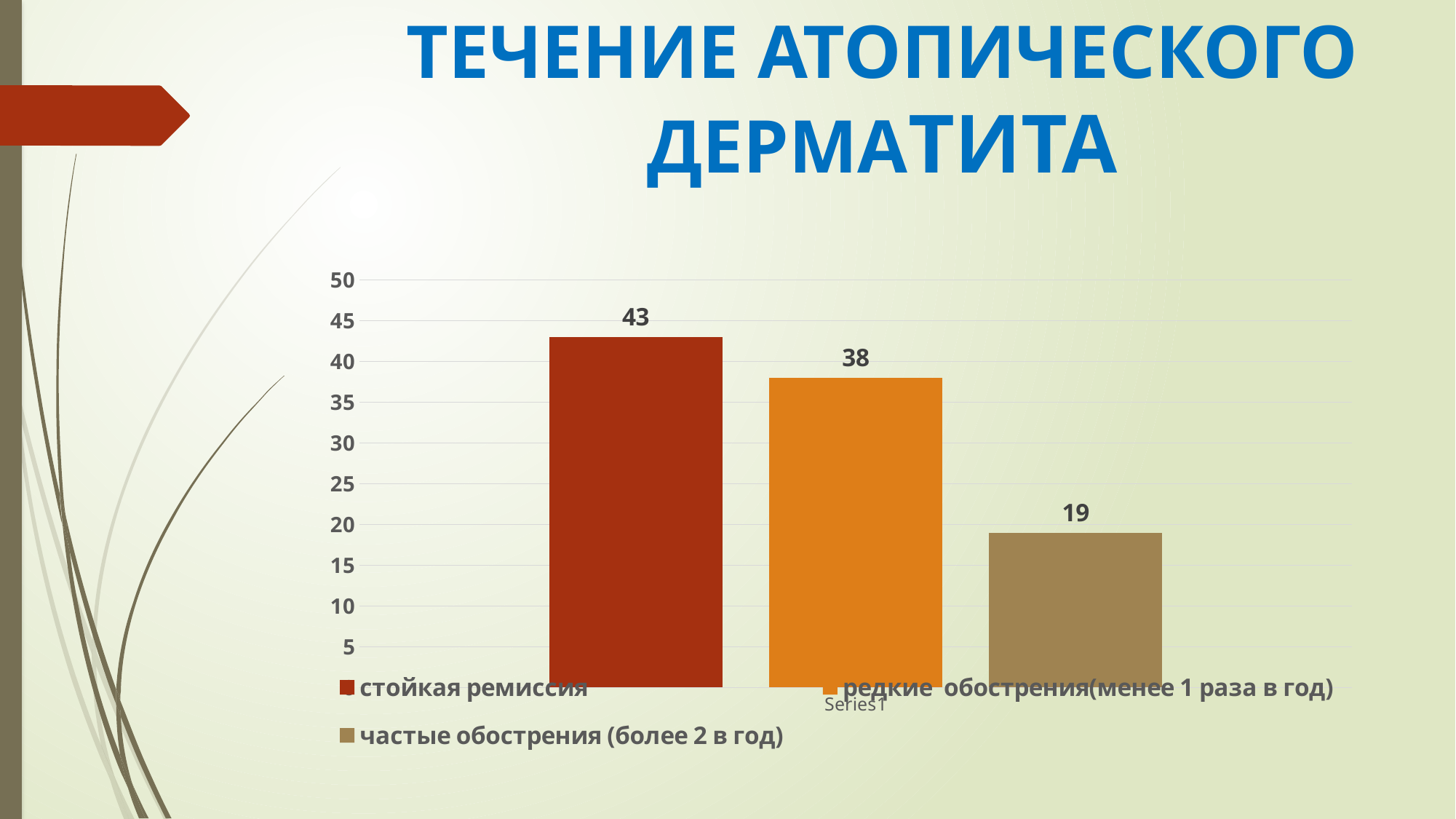
What is the difference between the values for стойкая ремиссия and редкие обострения (менее 1 раза в год)? 5 Which category has the highest value? стойкая ремиссия What kind of chart is shown on the slide? bar chart How many bars are plotted in the chart? 3 Which is larger, the value for редкие обострения (менее 1 раза в год) or the value for частые обострения (более 2 в год)? редкие обострения (менее 1 раза в год) What is the value for частые обострения (более 2 в год)? 19 What is the value for редкие обострения (менее 1 раза в год)? 38 What is the difference between the values for стойкая ремиссия and частые обострения (более 2 в год)? 24 Is the value for редкие обострения (менее 1 раза в год) greater or less than 40? less Which category has the lowest value? частые обострения (более 2 в год) How many entries does the legend list? 3 What is the value for стойкая ремиссия? 43